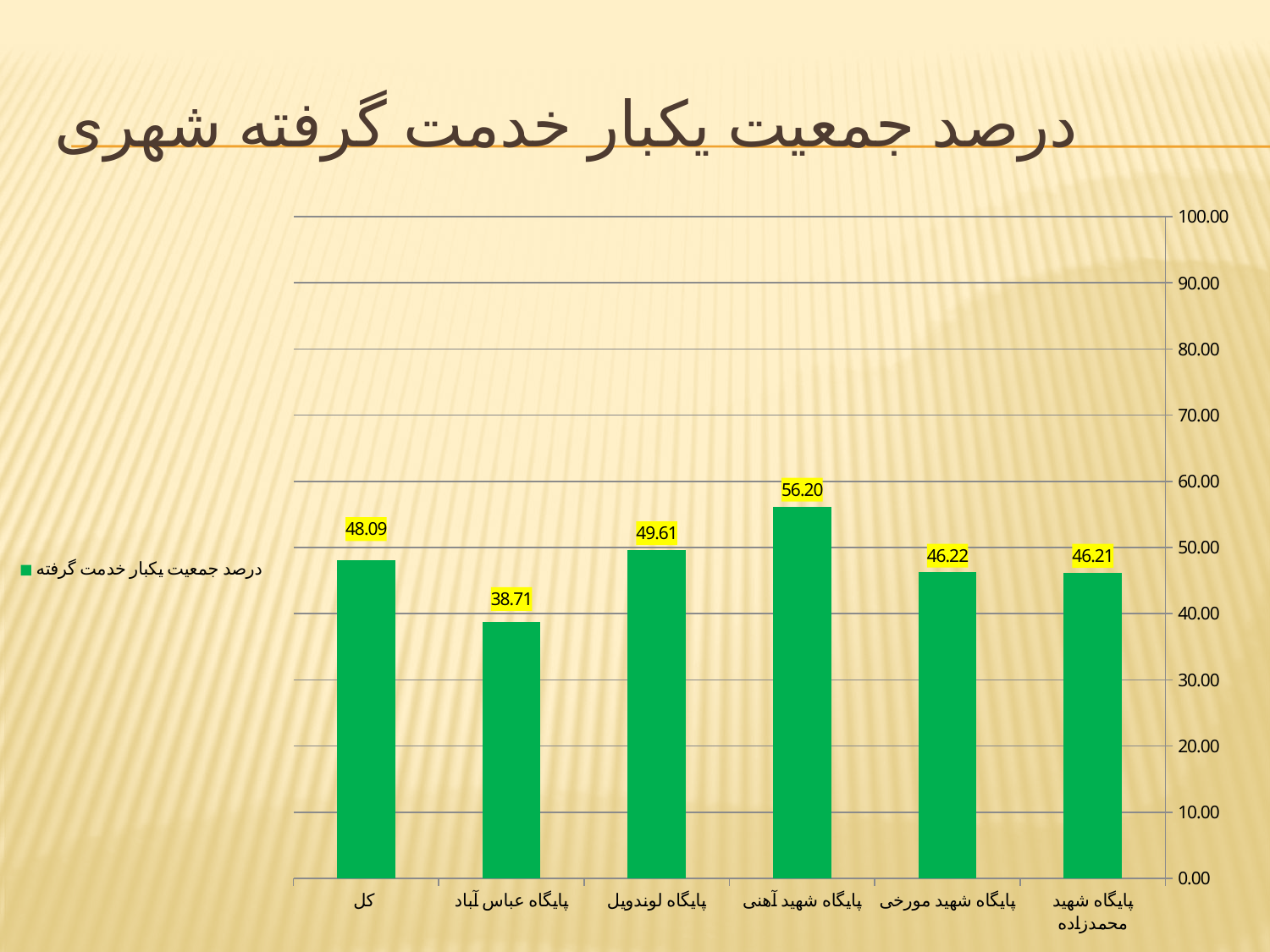
What is the value for کل? 48.09 How many categories are shown on the x axis? 6 What is the difference between the values for پایگاه شهید آهنی and پایگاه عباس آباد? 17.49 What is the value for پایگاه شهید آهنی? 56.20 Which category has the lowest value? پایگاه عباس آباد Which is larger, the value for کل or the value for پایگاه لوندویل? پایگاه لوندویل What is the value for پایگاه لوندویل? 49.61 How many series does the legend list? 1 What is the value for پایگاه عباس آباد? 38.71 Is the value for پایگاه شهید مورخی greater or less than 50.00? less What kind of chart is shown on the slide? bar chart Which category has the highest value? پایگاه شهید آهنی